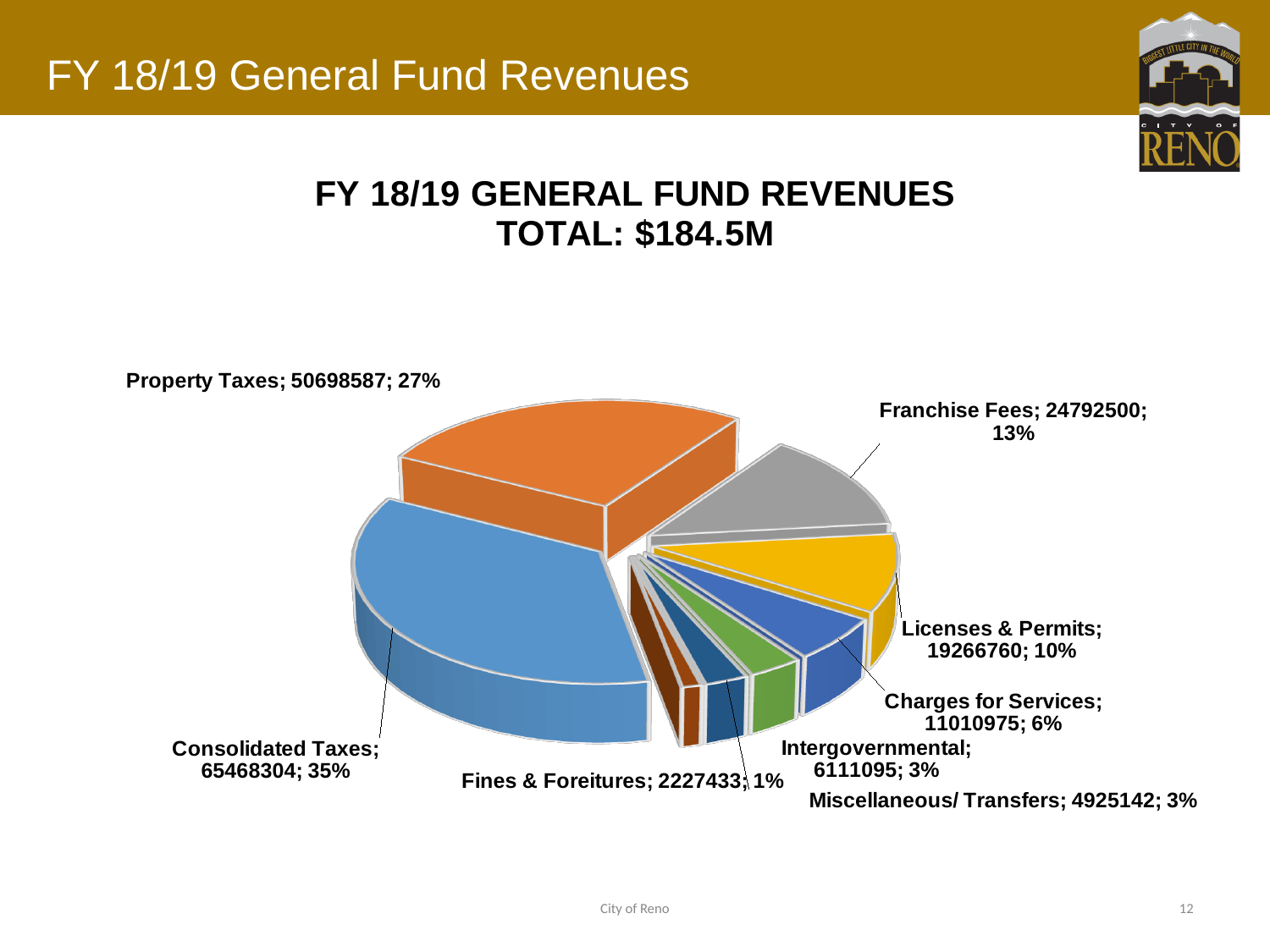
What total is stated in the chart title? $184.5M Which is larger, Franchise Fees or Charges for Services? Franchise Fees Which category has the largest slice of the pie? Consolidated Taxes What kind of chart is shown on the slide? Pie chart What is the value shown for Franchise Fees? 24792500 Which category has the smallest slice of the pie? Fines & Foreitures What share of the pie does Licenses & Permits represent? 10% What is the value shown for Property Taxes? 50698587 What is the value shown for Intergovernmental? 6111095 What is the difference between the Property Taxes value and the Franchise Fees value? 25906087 How many slices does the pie chart have? 8 What share of the pie does Consolidated Taxes represent? 35%